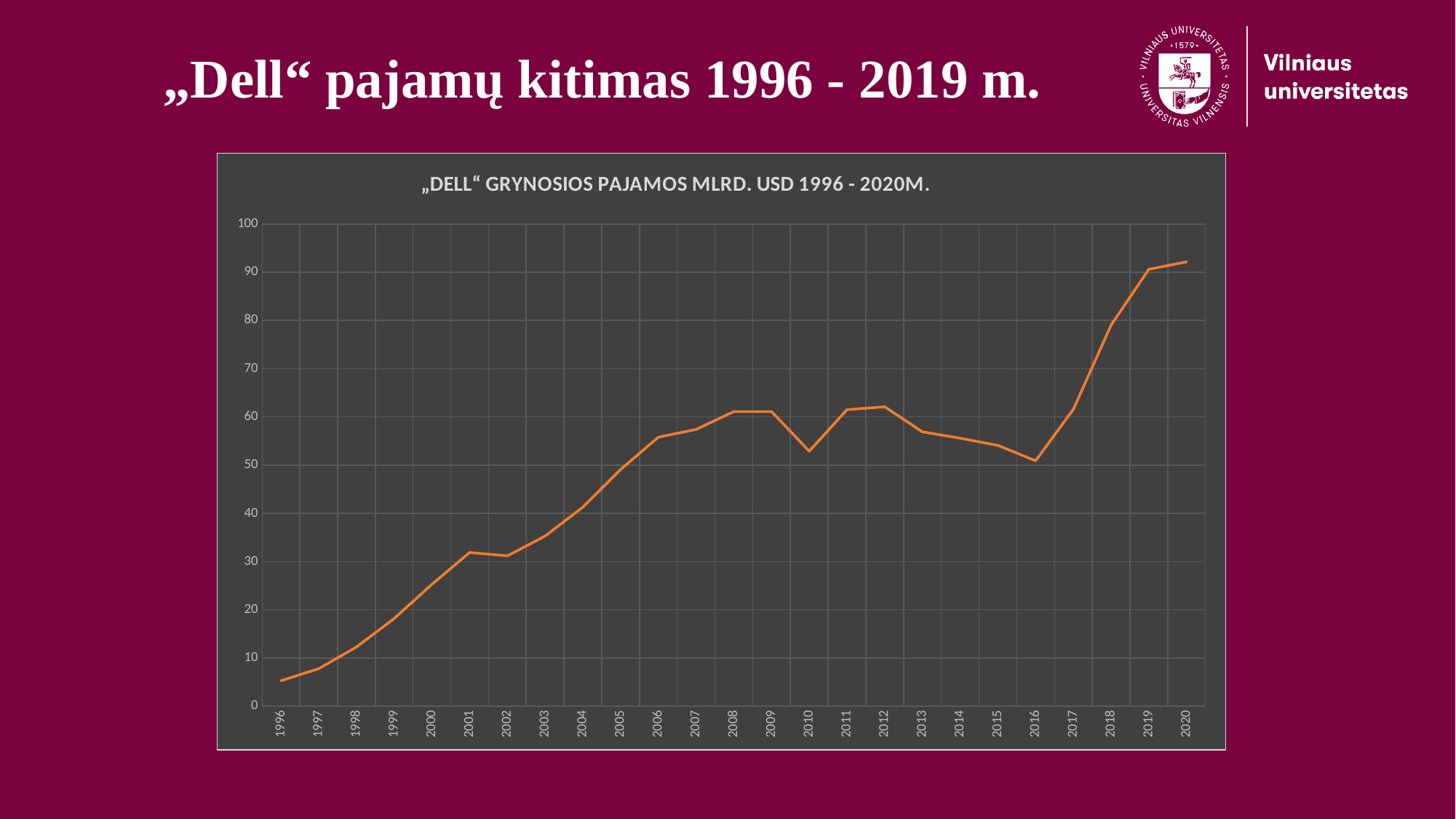
Which year has the larger value, 2012 or 2016? 2012 Which year has the lowest value on the chart? 1996 Which year has the larger value, 2008 or 2010? 2008 How many years are plotted along the x axis of the chart? 25 What is the title of the chart? „DELL“ GRYNOSIOS PAJAMOS MLRD. USD 1996 - 2020M. Which year has the highest value on the chart? 2020 Is the value for 1997 greater or less than 10? less Is the value for 2013 greater or less than 60? less Do the values rise or fall from 2012 to 2016? fall Is the value for 2001 greater or less than 30? greater What kind of chart is shown on the slide? line chart